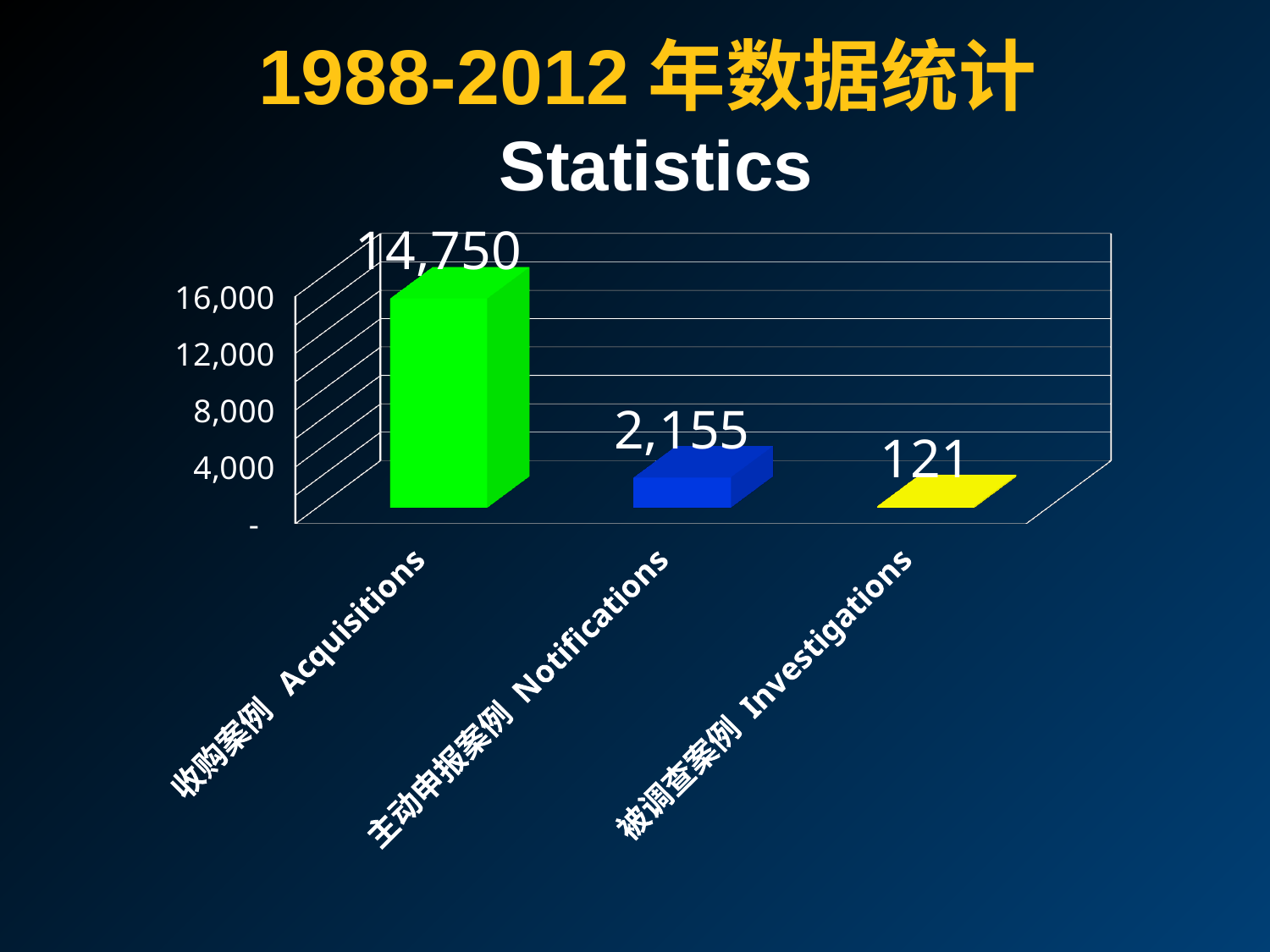
Which category has the highest value? Acquisitions What is the value for Investigations (被调查案例)? 121 What kind of chart is shown on the slide? bar chart What is the difference between the values for Acquisitions and Notifications? 12,595 What is the value for Notifications (主动申报案例)? 2,155 What is the value for Acquisitions (收购案例)? 14,750 What colour is the bar for Investigations? yellow Is the value for Acquisitions greater or less than 12,000? greater What is the difference between the values for Notifications and Investigations? 2,034 Which is larger, the value for Notifications or the value for Investigations? Notifications How many categories are shown in the chart? 3 Which category has the lowest value? Investigations